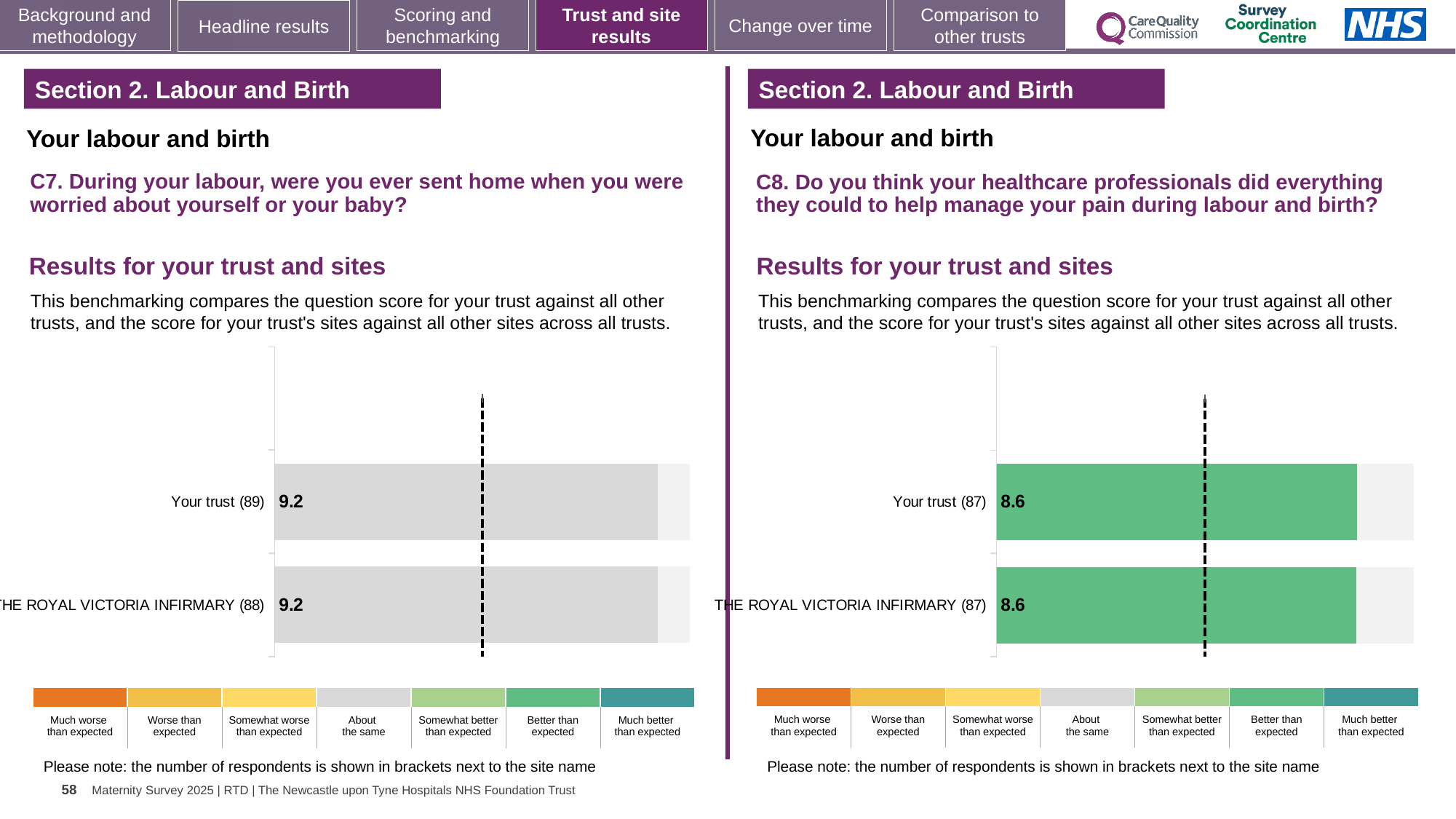
How many bars are plotted on the C8 chart (right)? 2 On the C8 chart (right), what is the score for THE ROYAL VICTORIA INFIRMARY (87)? 8.6 On the C8 chart (right), what is the difference between the score for Your trust (87) and the score for THE ROYAL VICTORIA INFIRMARY (87)? 0 On the C8 chart (right), what is the score for Your trust (87)? 8.6 On the C7 chart (left), what is the score for THE ROYAL VICTORIA INFIRMARY (88)? 9.2 On the C8 chart (right), which benchmark category does the green colour of the bars correspond to in the legend? Better than expected What kind of chart is the C8 chart (right)? Bar chart On the C7 chart (left), which benchmark category does the grey colour of the bars correspond to in the legend? About the same On the C7 chart (left), what is the score for Your trust (89)? 9.2 How many bars are plotted on the C7 chart (left)? 2 On the C7 chart (left), what is the difference between the score for Your trust (89) and the score for THE ROYAL VICTORIA INFIRMARY (88)? 0 Is the score for Your trust (89) on the C7 chart (left) larger than the score for Your trust (87) on the C8 chart (right)? Yes